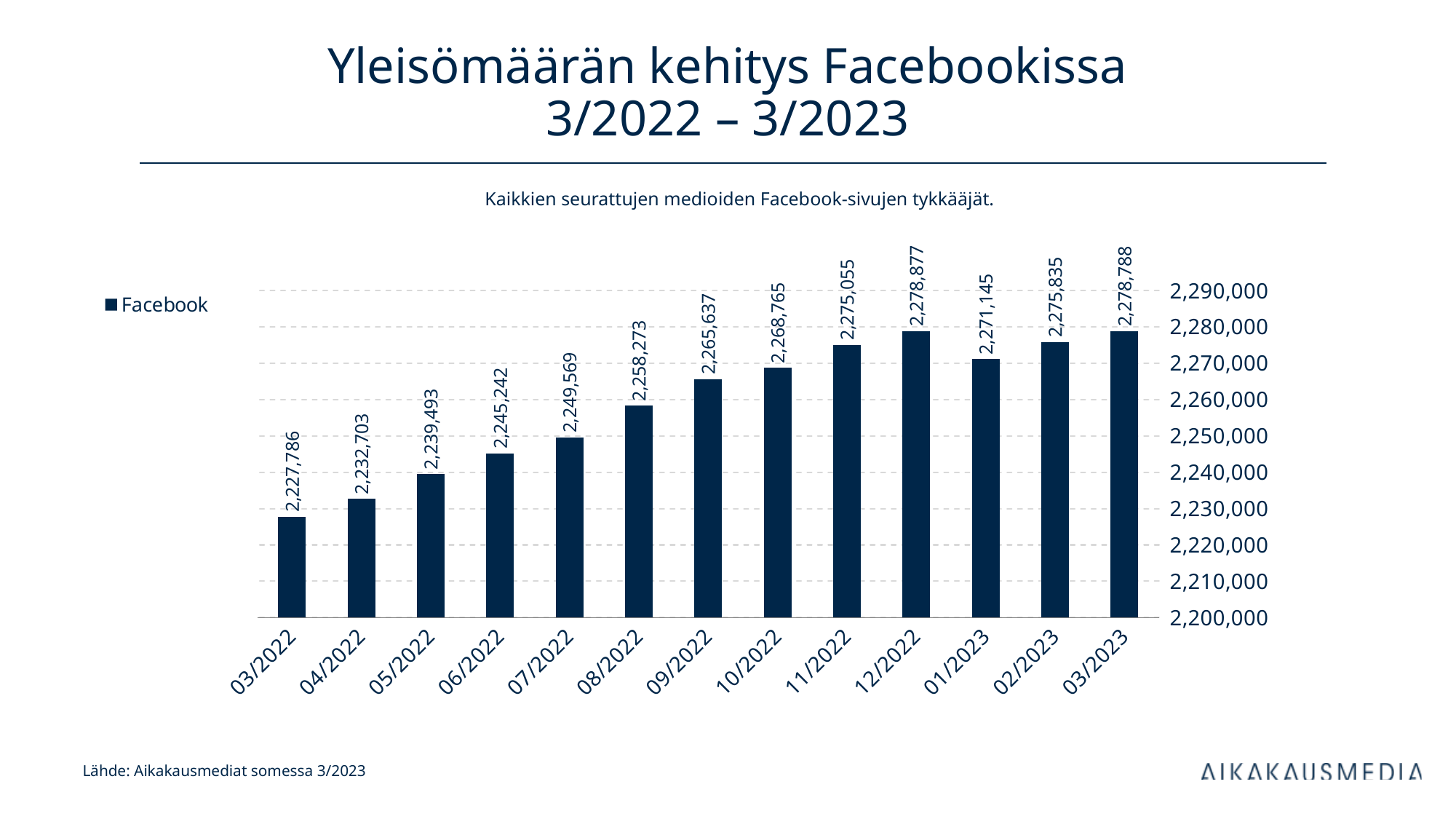
What kind of chart is shown on the slide? Bar chart Which is larger, the value for 01/2023 or the value for 11/2022? 11/2022 What is the difference between the values for 12/2022 and 01/2023? 7,732 How many months are shown on the x axis? 13 What is the value for 03/2023? 2,278,788 What is the value for 12/2022? 2,278,877 Which month has the lowest value? 03/2022 How many series does the legend list? 1 Which month has the highest value? 12/2022 What is the difference between the values for 03/2023 and 03/2022? 51,002 What is the value for 08/2022? 2,258,273 What is the value for 03/2022? 2,227,786